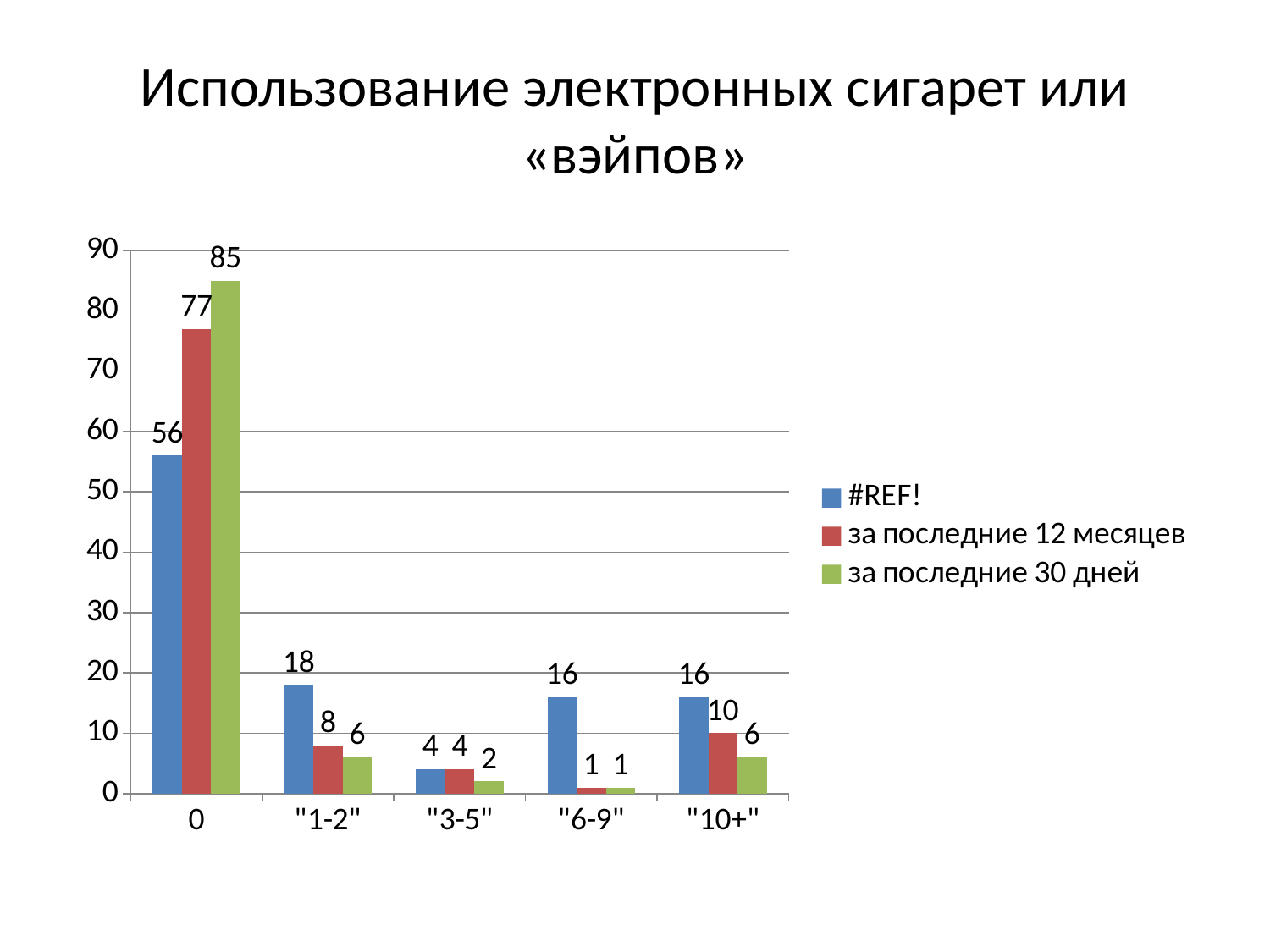
Does the "за последние 30 дней" series rise or fall from category 0 to category "1-2"? fall What type of chart is shown on the slide? bar chart What is the title of the chart? Использование электронных сигарет или «вэйпов» What is the value for the #REF! series in the category "1-2"? 18 How many series does the legend list? 3 How many categories are shown on the x axis? 5 What is the value for "за последние 12 месяцев" in the category "10+"? 10 In the category "6-9", which is larger: the #REF! value or the "за последние 12 месяцев" value? #REF! Which category has the highest value for the "за последние 12 месяцев" series? 0 What is the value for "за последние 30 дней" in the category 0? 85 What is the difference between the "за последние 30 дней" value and the #REF! value in the category 0? 29 Which category has the lowest value for the "за последние 30 дней" series? "6-9"